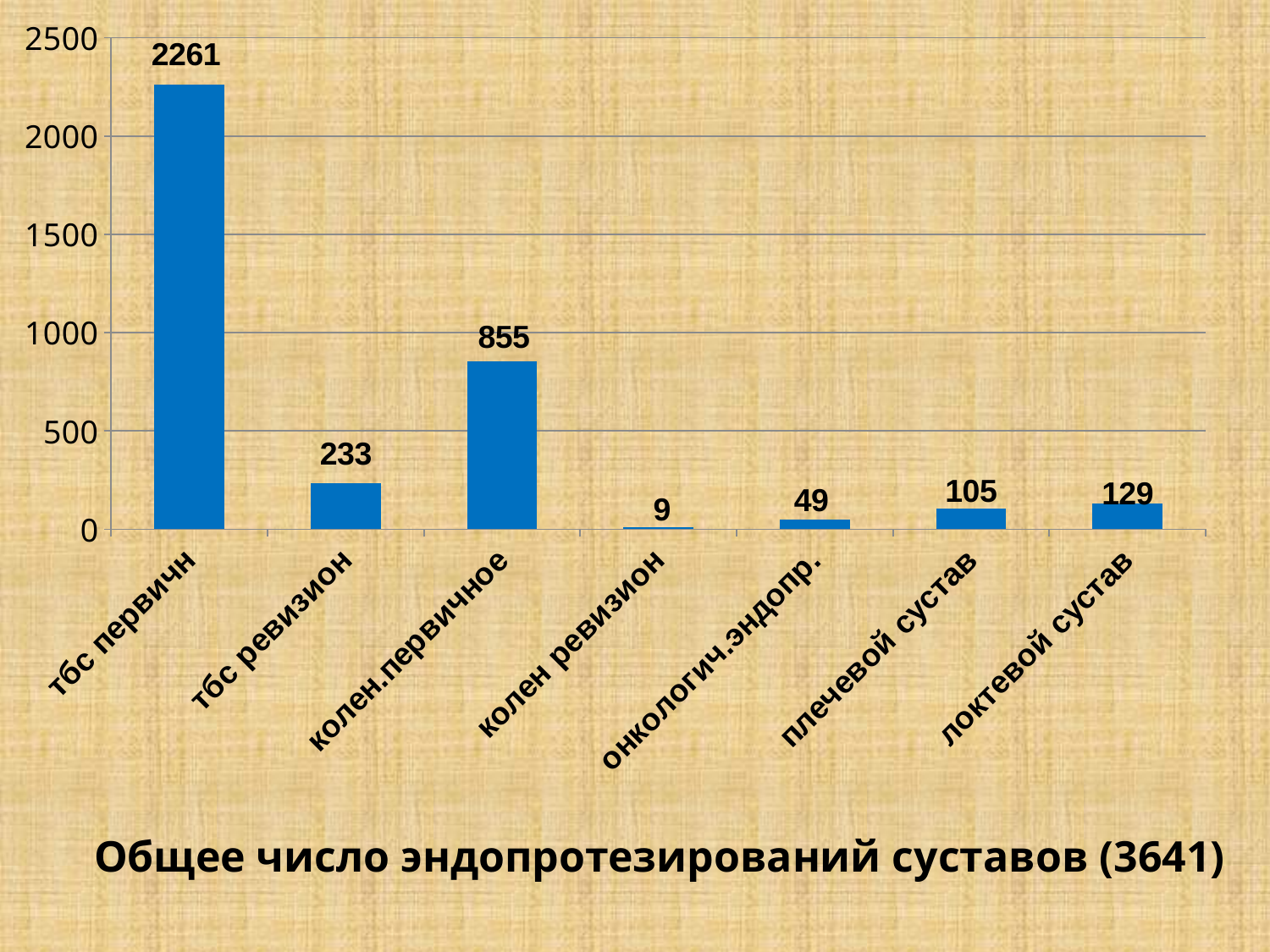
What is the difference between the values for локтевой сустав and плечевой сустав? 24 How many categories are shown on the x axis? 7 What is the value for локтевой сустав? 129 What total number is given in the caption below the chart? 3641 Which category has the highest value? тбс первичн What is the value for тбс первичн? 2261 What is the value for онкологич.эндопр.? 49 What is the difference between the values for тбс первичн and колен.первичное? 1406 Which category has the lowest value? колен ревизион What is the value for колен.первичное? 855 Which is larger, the value for тбс ревизион or the value for локтевой сустав? тбс ревизион What kind of chart is shown on the slide? bar chart